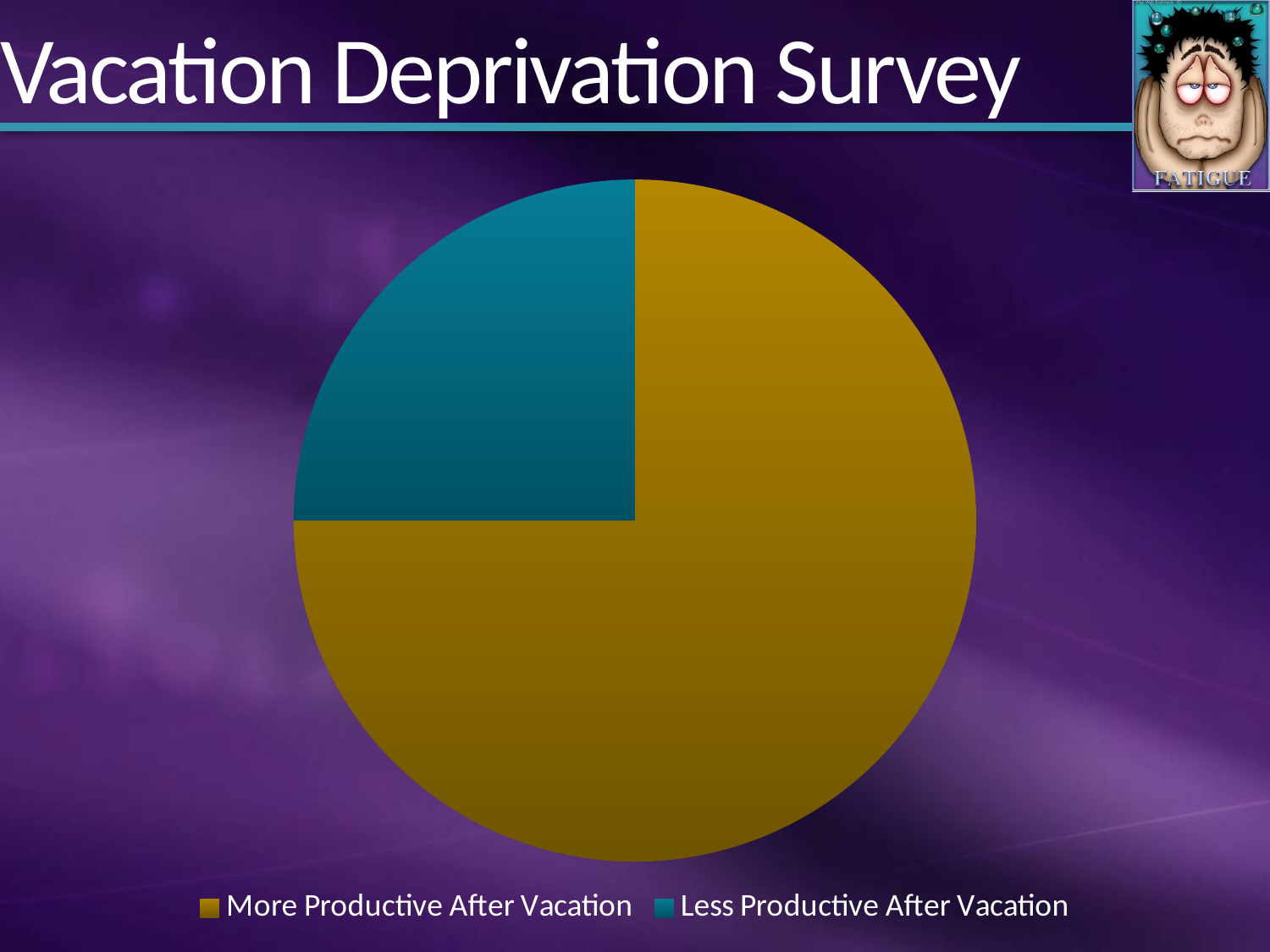
How many slices does the pie chart have? 2 Which slice of the pie chart is the largest? More Productive After Vacation Which slice of the pie chart is the smallest? Less Productive After Vacation What colour is the More Productive After Vacation slice in the pie chart? gold Which is larger in the pie chart: More Productive After Vacation or Less Productive After Vacation? More Productive After Vacation How many entries does the legend of the pie chart list? 2 What is the title of the slide containing the pie chart? Vacation Deprivation Survey What kind of chart is shown on the slide? pie chart